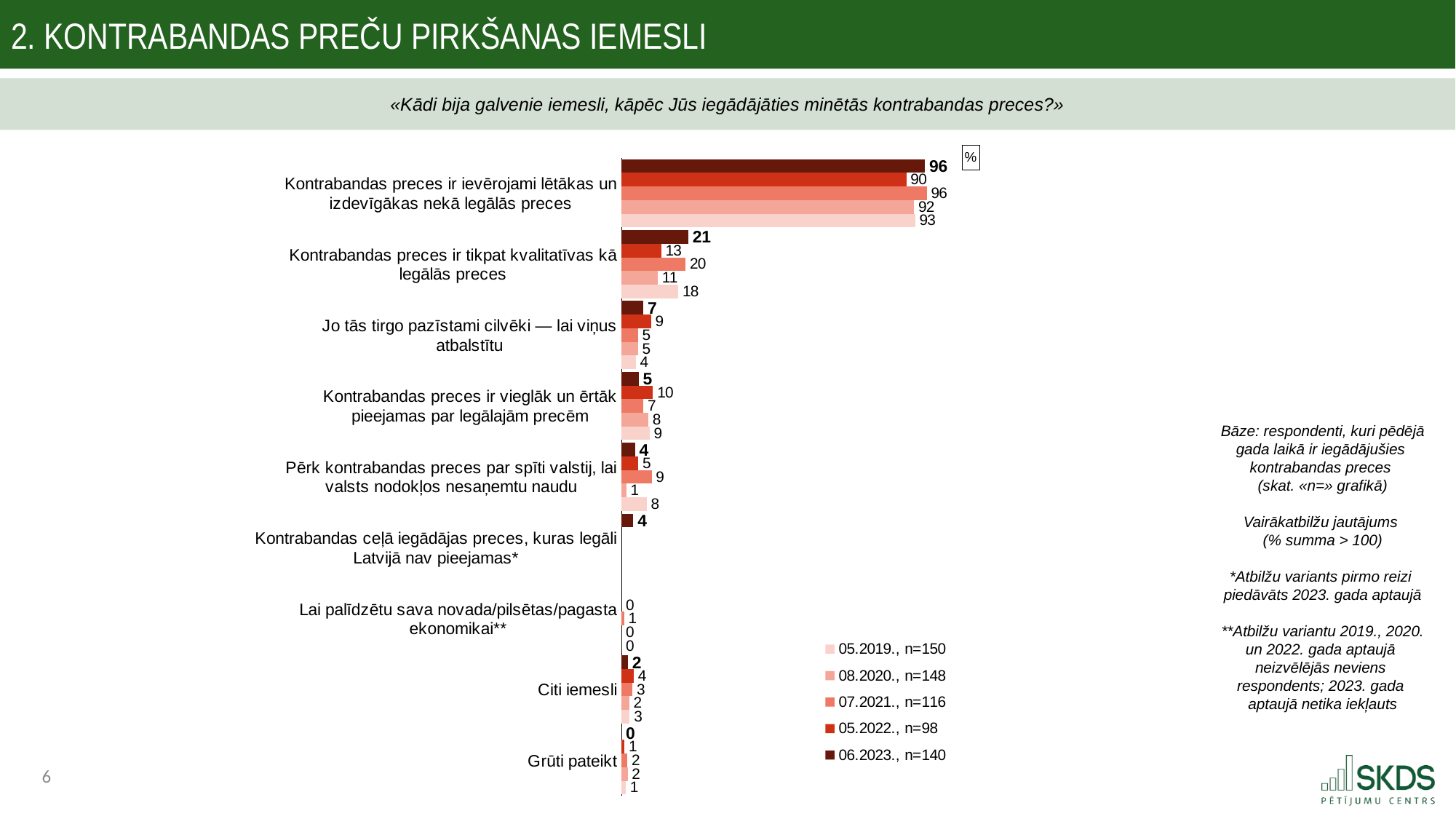
How many series does the legend list? 5 What kind of chart is shown on the slide? bar chart What is the value for 05.2019 for "Kontrabandas preces ir vieglāk un ērtāk pieejamas par legālajām precēm"? 9 What is the sample size (n) shown in the legend for 06.2023? n=140 What is the value for 06.2023 for "Kontrabandas ceļā iegādājas preces, kuras legāli Latvijā nav pieejamas*"? 4 What is the value for 05.2022 for "Citi iemesli"? 4 What is the value for 05.2022 for "Kontrabandas preces ir tikpat kvalitatīvas kā legālās preces"? 13 What is the difference between the 06.2023 and 05.2022 values for "Kontrabandas preces ir tikpat kvalitatīvas kā legālās preces"? 8 How many answer categories are shown on the chart? 9 For "Pērk kontrabandas preces par spīti valstij, lai valsts nodokļos nesaņemtu naudu", which is larger: the 07.2021 value or the 08.2020 value? 07.2021 What is the value for 06.2023 for "Kontrabandas preces ir ievērojami lētākas un izdevīgākas nekā legālās preces"? 96 Which category has the highest value for 06.2023? Kontrabandas preces ir ievērojami lētākas un izdevīgākas nekā legālās preces